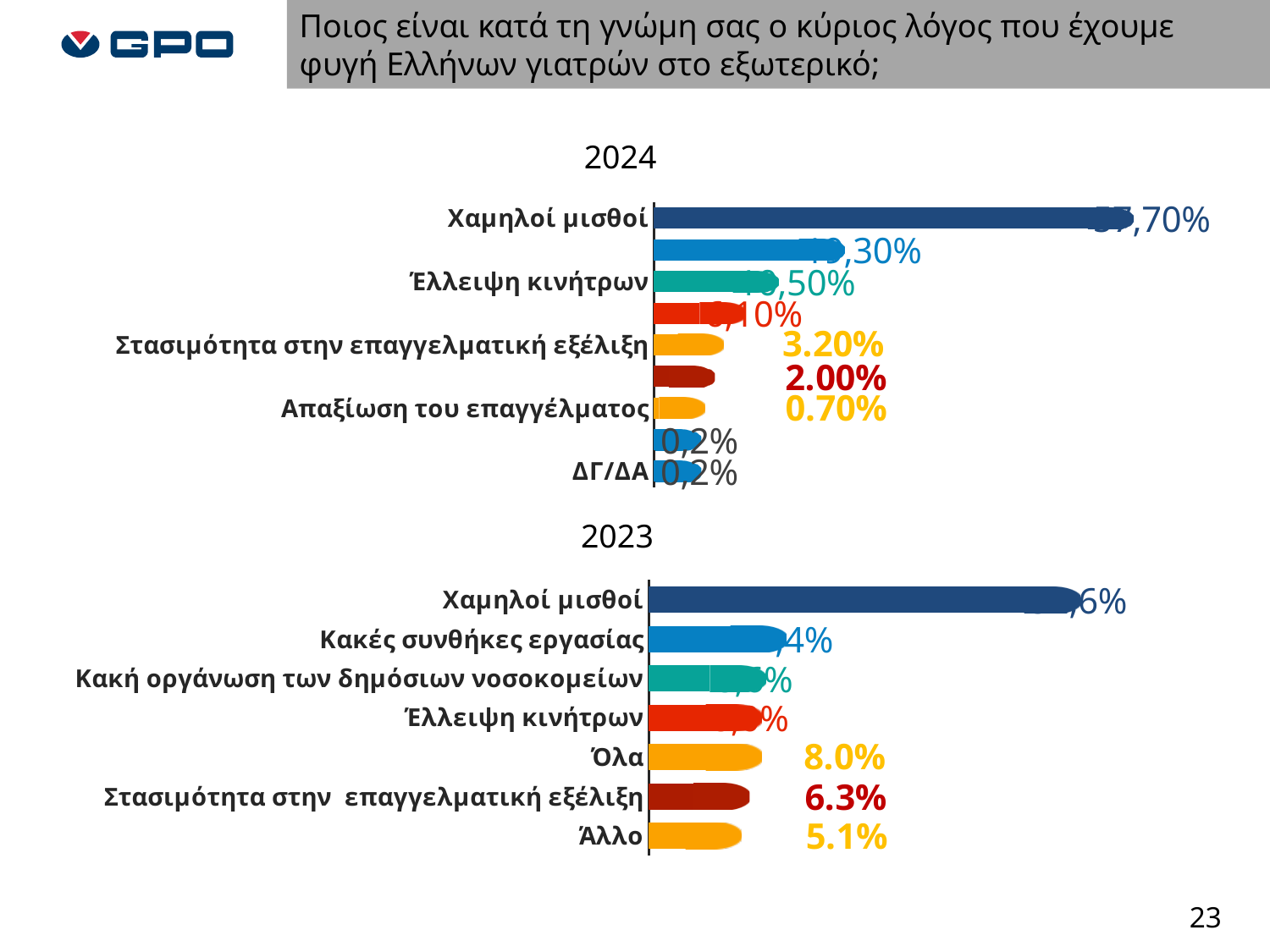
In the 2024 chart, what is the value for Στασιμότητα στην επαγγελματική εξέλιξη? 3.20% In the 2023 chart, which is larger, Όλα or Στασιμότητα στην επαγγελματική εξέλιξη? Όλα In the 2024 chart, what is the difference between Στασιμότητα στην επαγγελματική εξέλιξη and Απαξίωση του επαγγέλματος? 2.50% In the 2023 chart, what is the value for Όλα? 8.0% In the 2023 chart, what is the difference between Όλα and Άλλο? 2.9% In the 2023 chart, what is the value for Άλλο? 5.1% How many bars does the 2023 chart show? 7 In the 2024 chart, what is the value for Απαξίωση του επαγγέλματος? 0.70% In the 2023 chart, what is the value for Στασιμότητα στην επαγγελματική εξέλιξη? 6.3% In the 2023 chart, which category has the lowest value? Άλλο In the 2024 chart, what is the value for ΔΓ/ΔΑ? 0,2% In the 2024 chart, which category has the highest value? Χαμηλοί μισθοί